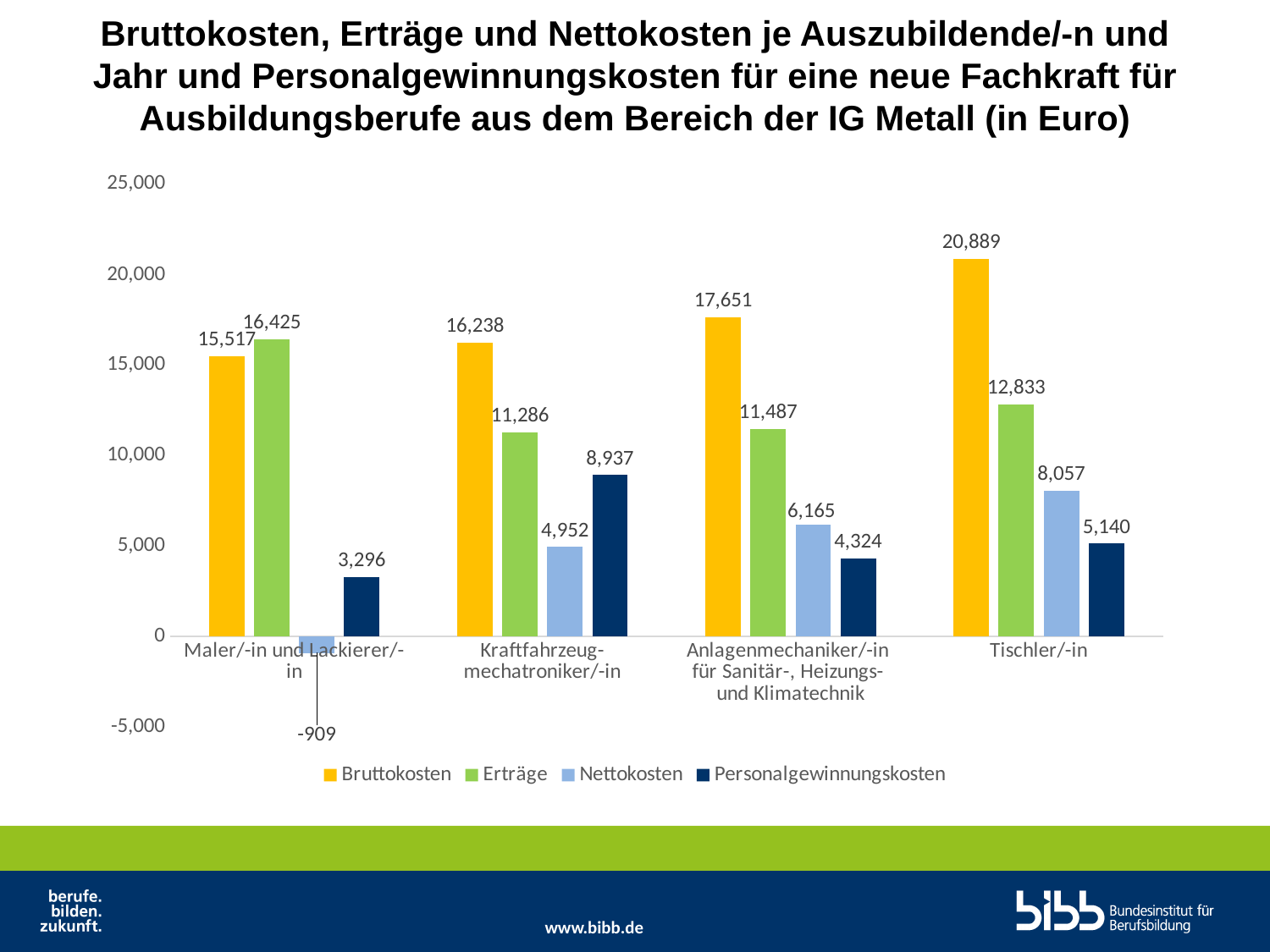
How many occupations are shown on the x axis? 4 What is the Erträge value for Anlagenmechaniker/-in für Sanitär-, Heizungs- und Klimatechnik? 11,487 What is the Personalgewinnungskosten value for Kraftfahrzeugmechatroniker/-in? 8,937 Which is larger for Maler/-in und Lackierer/-in: Bruttokosten or Erträge? Erträge Which occupation has the lowest Nettokosten? Maler/-in und Lackierer/-in What is the Nettokosten value for Maler/-in und Lackierer/-in? -909 What is the difference between Bruttokosten and Erträge for Tischler/-in? 8,056 Which series is shown in dark blue in the legend? Personalgewinnungskosten How many series does the legend list? 4 What kind of chart is shown on the slide? Bar chart What is the Bruttokosten value for Tischler/-in? 20,889 Which occupation has the highest Bruttokosten? Tischler/-in